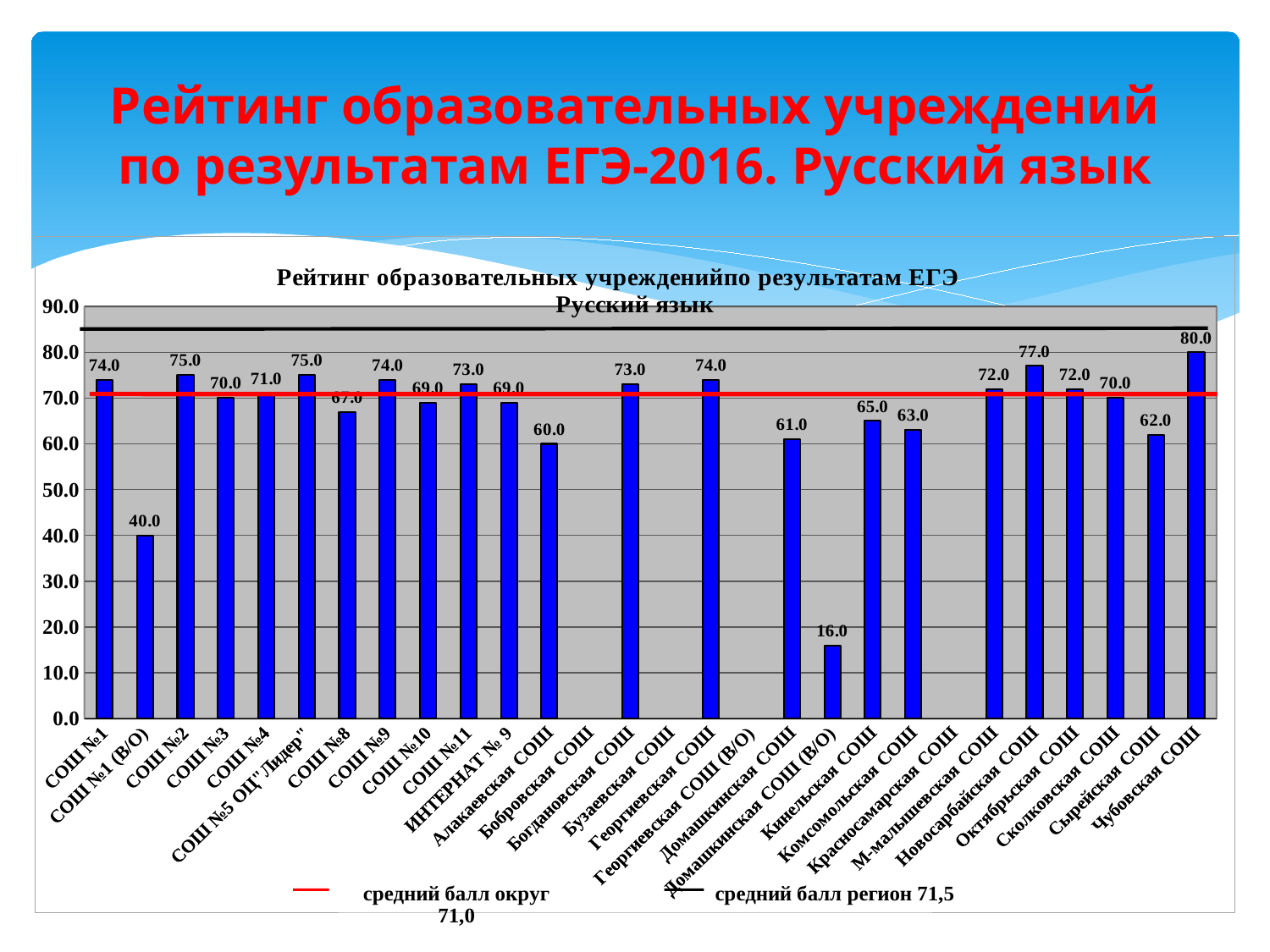
What is the value for СОШ №1 (В/О)? 40.0 What is the difference between the values for Чубовская СОШ and Домашкинская СОШ (В/О)? 64.0 What is the value for Чубовская СОШ? 80.0 Which has a larger value, СОШ №2 or СОШ №8? СОШ №2 Which institution has the highest value? Чубовская СОШ What is the value for Кинельская СОШ? 65.0 What does the red horizontal line in the chart represent, according to the legend? средний балл округ 71,0 Which institution has the lowest value? Домашкинская СОШ (В/О) What is the value for Новосарбайская СОШ? 77.0 What kind of chart is shown on the slide? bar chart What is the difference between the values for Новосарбайская СОШ and Алакаевская СОШ? 17.0 Is the value for Сырейская СОШ greater or less than 70.0? less